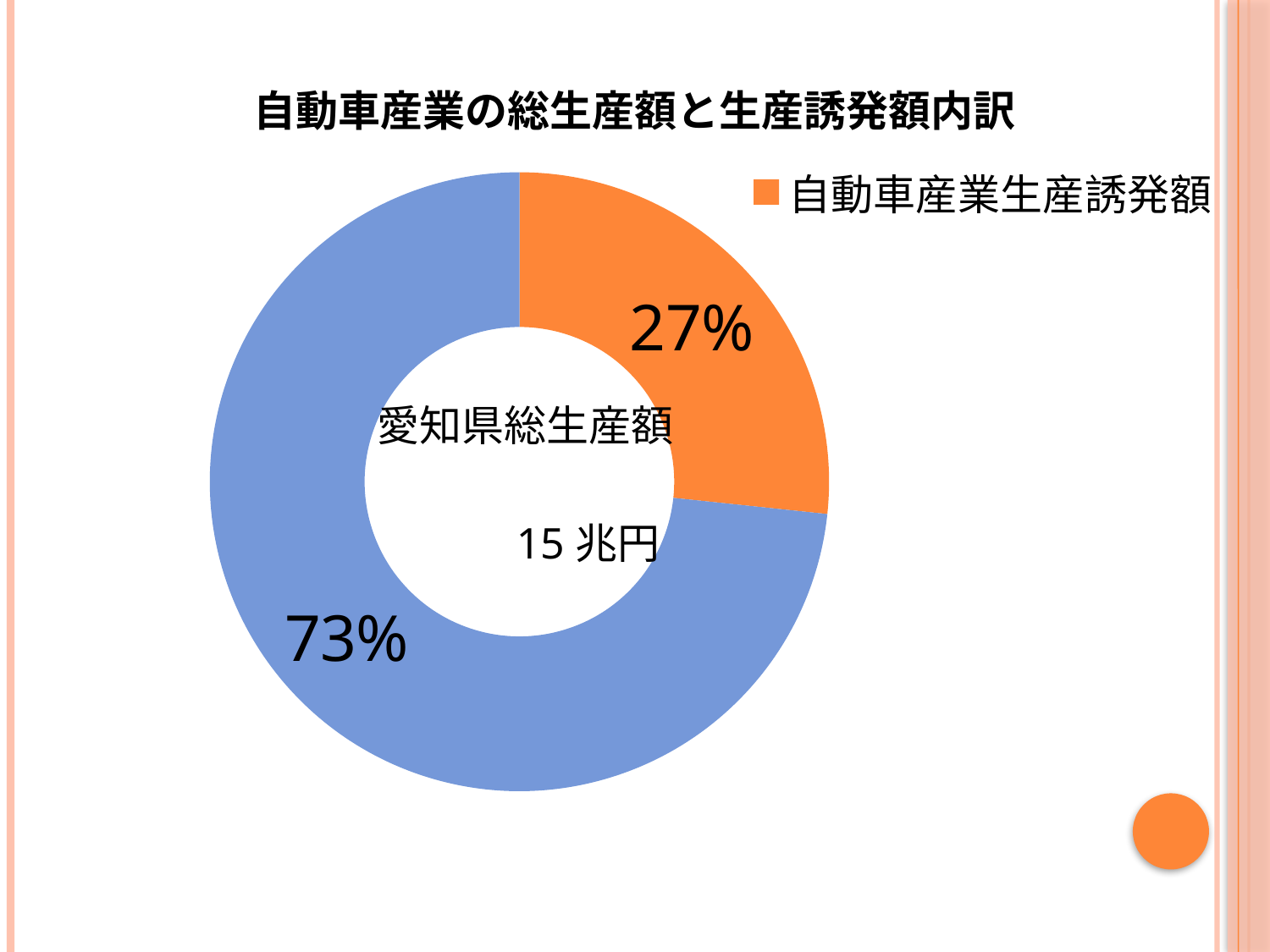
How many slices does the doughnut chart have? 2 What is the title of the chart? 自動車産業の総生産額と生産誘発額内訳 What share of the doughnut chart does 自動車産業生産誘発額 represent? 27% Is the share for 自動車産業生産誘発額 greater or less than 50%? less Is the share for 自動車産業生産誘発額 larger or smaller than the share of the blue slice? smaller Which slice of the doughnut chart is the largest? the blue slice (73%) Which slice of the doughnut chart is the smallest? 自動車産業生産誘発額 (27%) What total value is printed in the centre of the doughnut chart for 愛知県総生産額? 15 兆円 What is the difference in percentage points between the blue slice and the 自動車産業生産誘発額 slice? 46 percentage points What share of the doughnut chart does the blue slice represent? 73% How many entries does the chart legend list? 1 What kind of chart is shown on the slide? doughnut chart